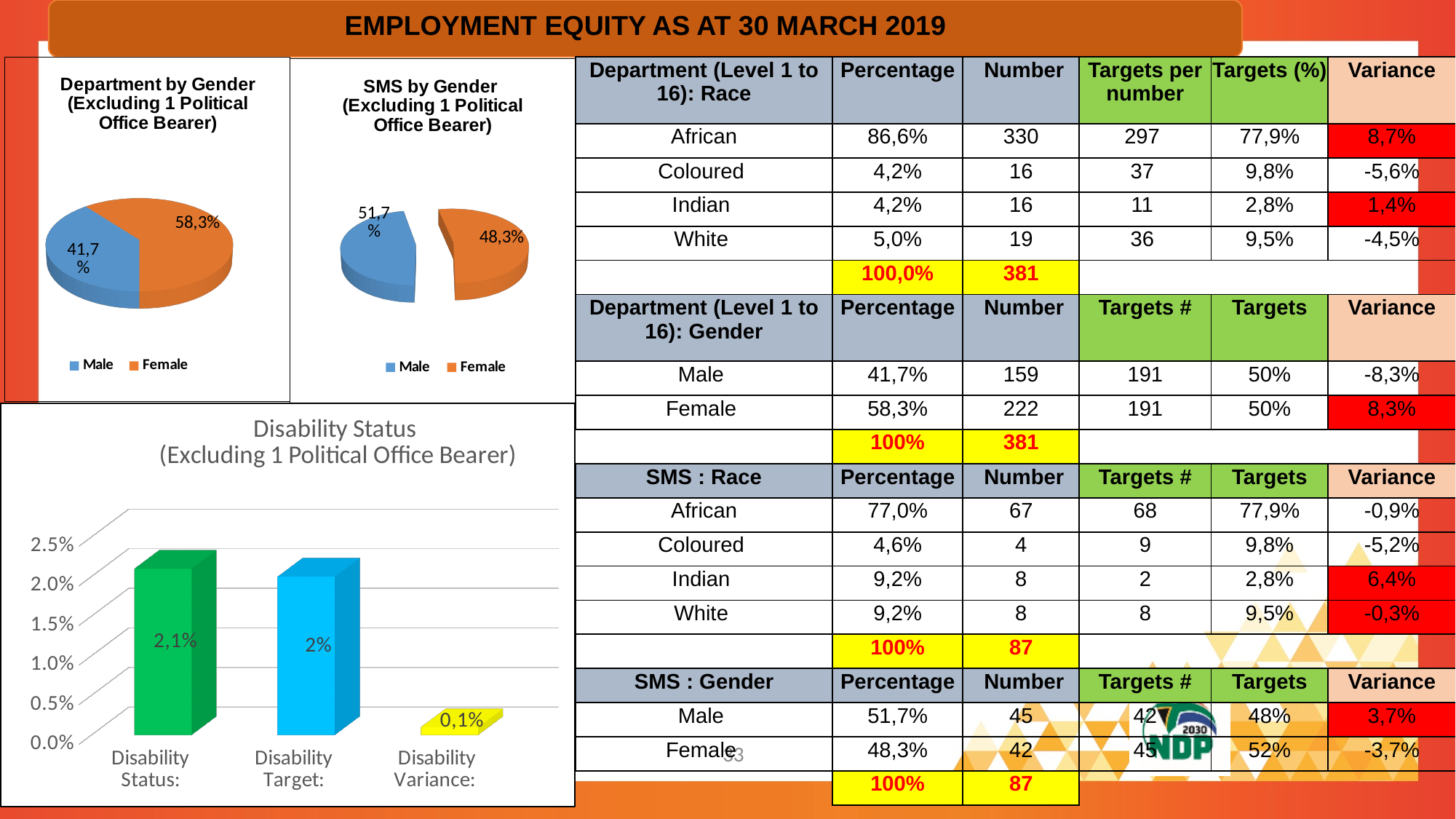
What kind of chart is the 'Disability Status' chart? Bar chart In the 'SMS by Gender' pie chart, what share is Male? 51,7% In the 'Disability Status' chart, which category has the lowest value? Disability Variance How many categories are shown in the 'Disability Status' chart? 3 In the 'Department by Gender' pie chart, what is the difference between the Female and Male shares? 16,6% In the 'Department by Gender' pie chart, what share is Female? 58,3% In the 'Disability Status' chart, what is the value for Disability Status? 2,1% In the 'SMS by Gender' pie chart, what share is Female? 48,3% In the 'Disability Status' chart, what is the value for Disability Target? 2% How many series does the legend of the 'Department by Gender' pie chart list? 2